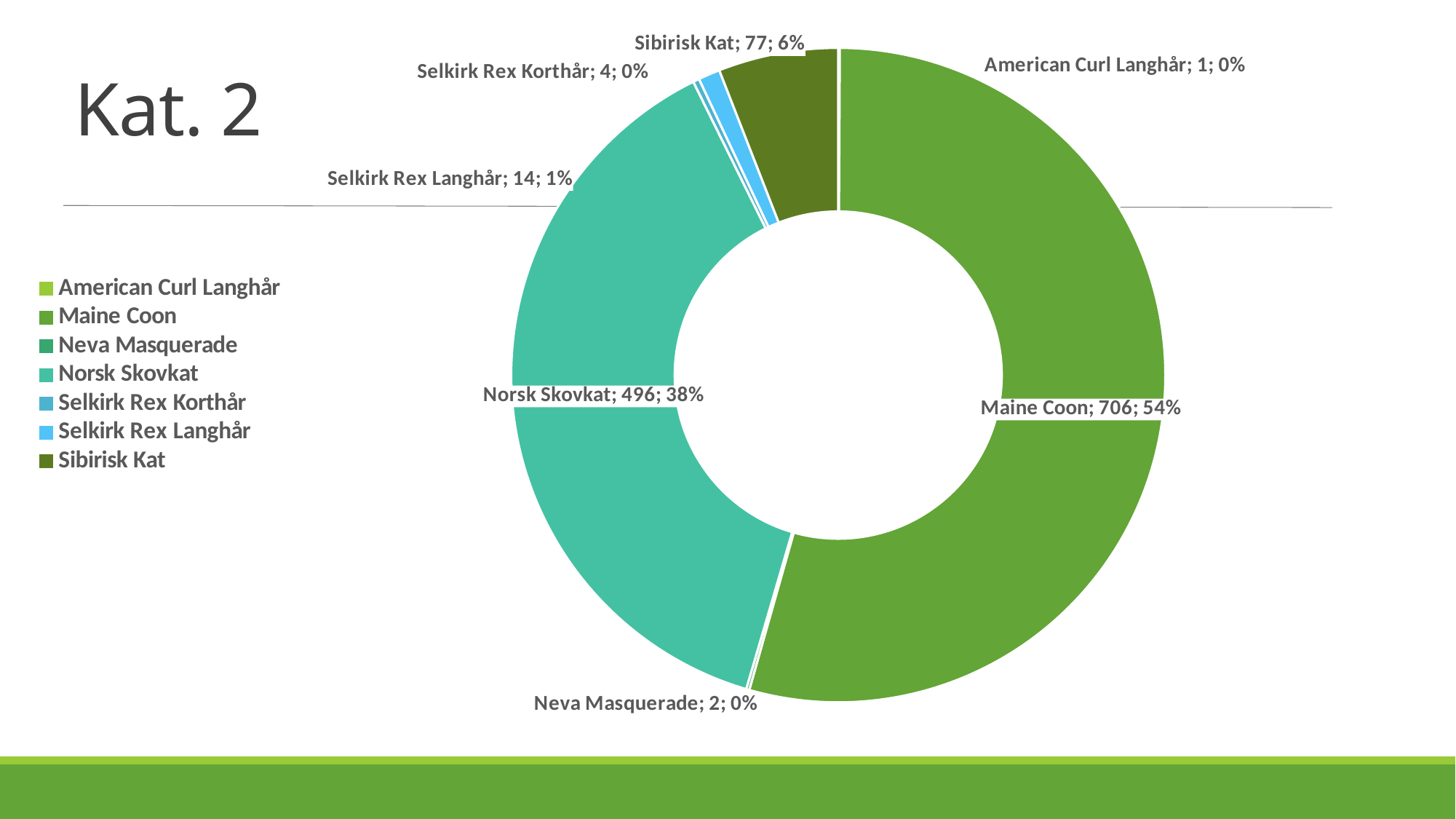
What is the value for Maine Coon? 706 Which category has the lowest value? American Curl Langhår What share of the chart does Norsk Skovkat represent? 38% What is the value for Sibirisk Kat? 77 Which category has the highest value? Maine Coon What is the difference between the values for Maine Coon and Norsk Skovkat? 210 What kind of chart is shown on the slide? Doughnut (pie) chart What is the value for Selkirk Rex Langhår? 14 What is the value for Norsk Skovkat? 496 What is the title of the slide? Kat. 2 Which is larger, the value for Sibirisk Kat or the value for Selkirk Rex Langhår? Sibirisk Kat How many categories does the legend list? 7